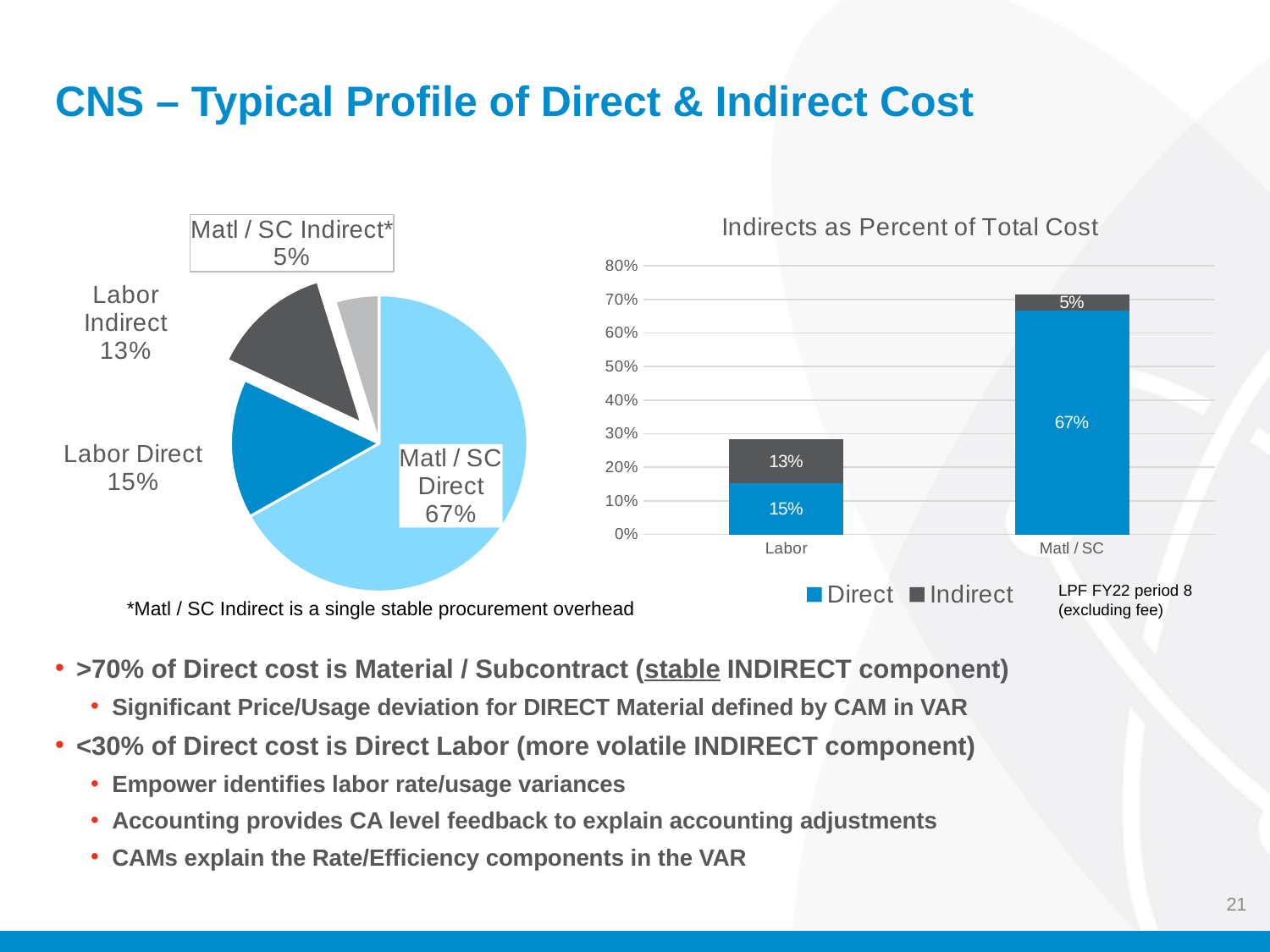
In the 'Indirects as Percent of Total Cost' chart, what is the total of the stacked bar for Matl / SC? 72% How many series does the legend of the 'Indirects as Percent of Total Cost' chart list? 2 In the 'Indirects as Percent of Total Cost' chart, what is the difference between the Direct values for Matl / SC and Labor? 52% In the pie chart on the left, what share does Matl / SC Direct have? 67% What kind of chart is the 'Indirects as Percent of Total Cost' chart? Stacked bar chart In the 'Indirects as Percent of Total Cost' chart, what is the Indirect value for Matl / SC? 5% In the pie chart on the left, what share does Labor Indirect have? 13% In the 'Indirects as Percent of Total Cost' chart, what is the total of the stacked bar for Labor? 28% How many slices does the pie chart on the left have? 4 In the 'Indirects as Percent of Total Cost' chart, what is the Direct value for Labor? 15% In the pie chart on the left, which slice is the largest? Matl / SC Direct In the pie chart on the left, which slice is the smallest? Matl / SC Indirect